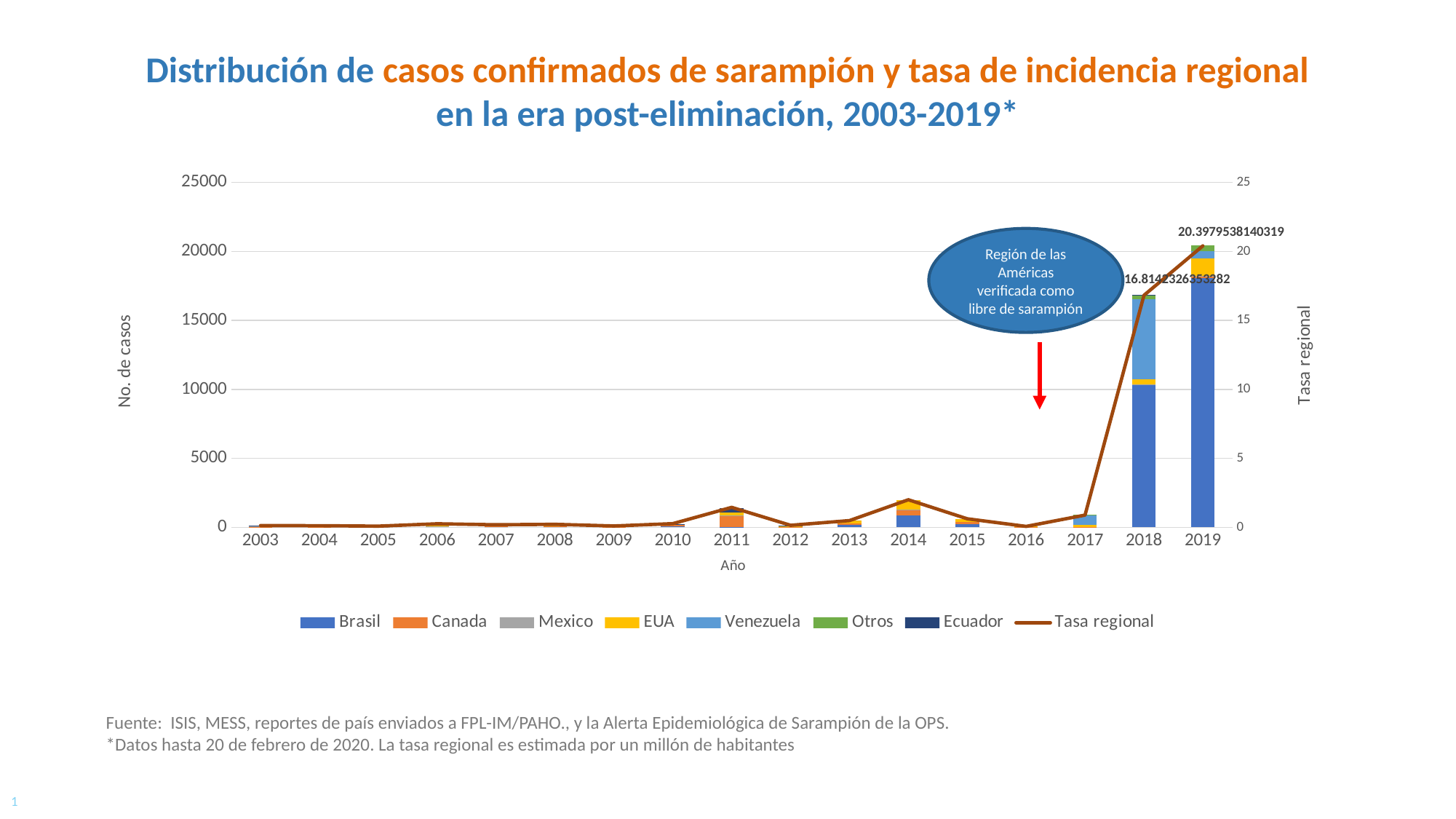
Which year has more confirmed cases, 2018 or 2019? 2019 Does the Tasa regional line rise or fall from 2016 to 2019? rise How many years are shown on the x axis? 17 Which year has more confirmed cases, 2011 or 2014? 2014 By how much did the Tasa regional increase from 2018 to 2019? 3.5837211787037 Is the total number of cases in 2017 greater or less than 5000? less How many series does the legend list? 8 Is the total number of cases in 2018 greater or less than 15000? greater What kind of chart is this? Combined stacked bar and line chart Which year has the highest total number of confirmed cases? 2019 What is the value of the Tasa regional line for 2019? 20.3979538140319 What is the value of the Tasa regional line for 2018? 16.8142326353282